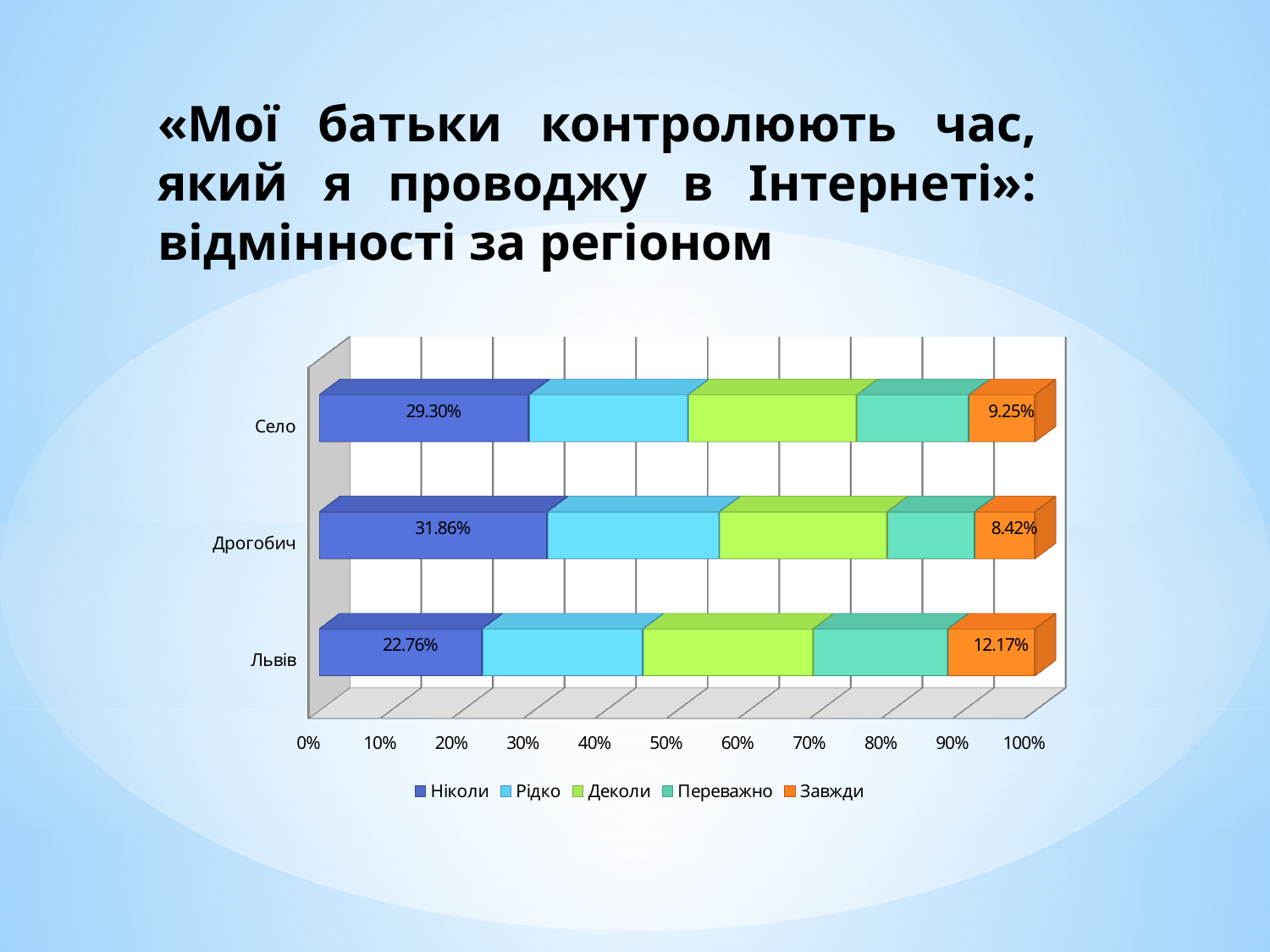
Which is larger: the Завжди value for Село or for Львів? Львів What is the value for Ніколи for Дрогобич? 31.86% What is the value for Завжди for Львів? 12.17% Which region has the lowest value for Завжди? Дрогобич Which region has the highest value for Ніколи? Дрогобич What is the difference between the Ніколи values for Дрогобич and Львів? 9.10% Which series is shown in orange in the legend? Завжди What is the value for Завжди for Дрогобич? 8.42% What is the value for Ніколи for Село? 29.30% What kind of chart is shown on the slide? Stacked bar chart How many series does the legend list? 5 How many regions are shown on the chart? 3